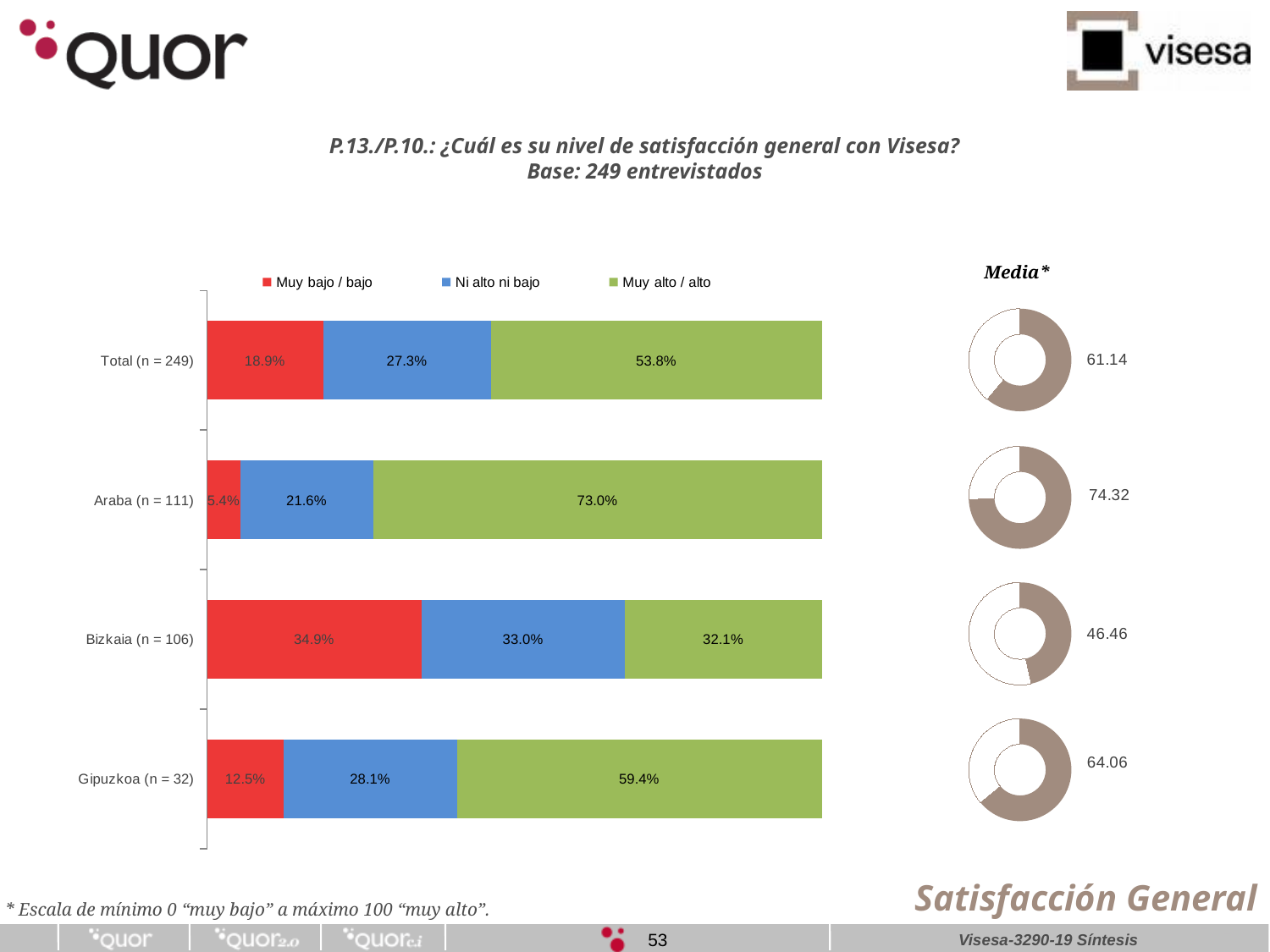
How many categories are shown in the stacked bar chart? 4 How many series does the legend of the stacked bar chart list? 3 In the stacked bar chart, what is the 'Muy bajo / bajo' value for Bizkaia (n = 106)? 34.9% In the stacked bar chart, which category has the highest 'Muy alto / alto' share? Araba (n = 111) In the stacked bar chart, what percentage of Araba (n = 111) respondents answered 'Muy alto / alto'? 73.0% In the 'Media*' donut charts on the right, what is the mean value shown for Bizkaia (n = 106)? 46.46 In the stacked bar chart, which category has the lowest 'Muy bajo / bajo' share? Araba (n = 111) What kind of chart is the main chart on the left of the slide? Stacked bar chart In the 'Media*' donut charts on the right, which category has the highest mean value? Araba (n = 111) In the stacked bar chart, which is larger: the 'Ni alto ni bajo' value for Bizkaia (n = 106) or for Gipuzkoa (n = 32)? Bizkaia (n = 106) In the stacked bar chart, what is the difference between the 'Muy alto / alto' values for Gipuzkoa (n = 32) and Bizkaia (n = 106)? 27.3% In the stacked bar chart, what is the 'Ni alto ni bajo' value for Total (n = 249)? 27.3%